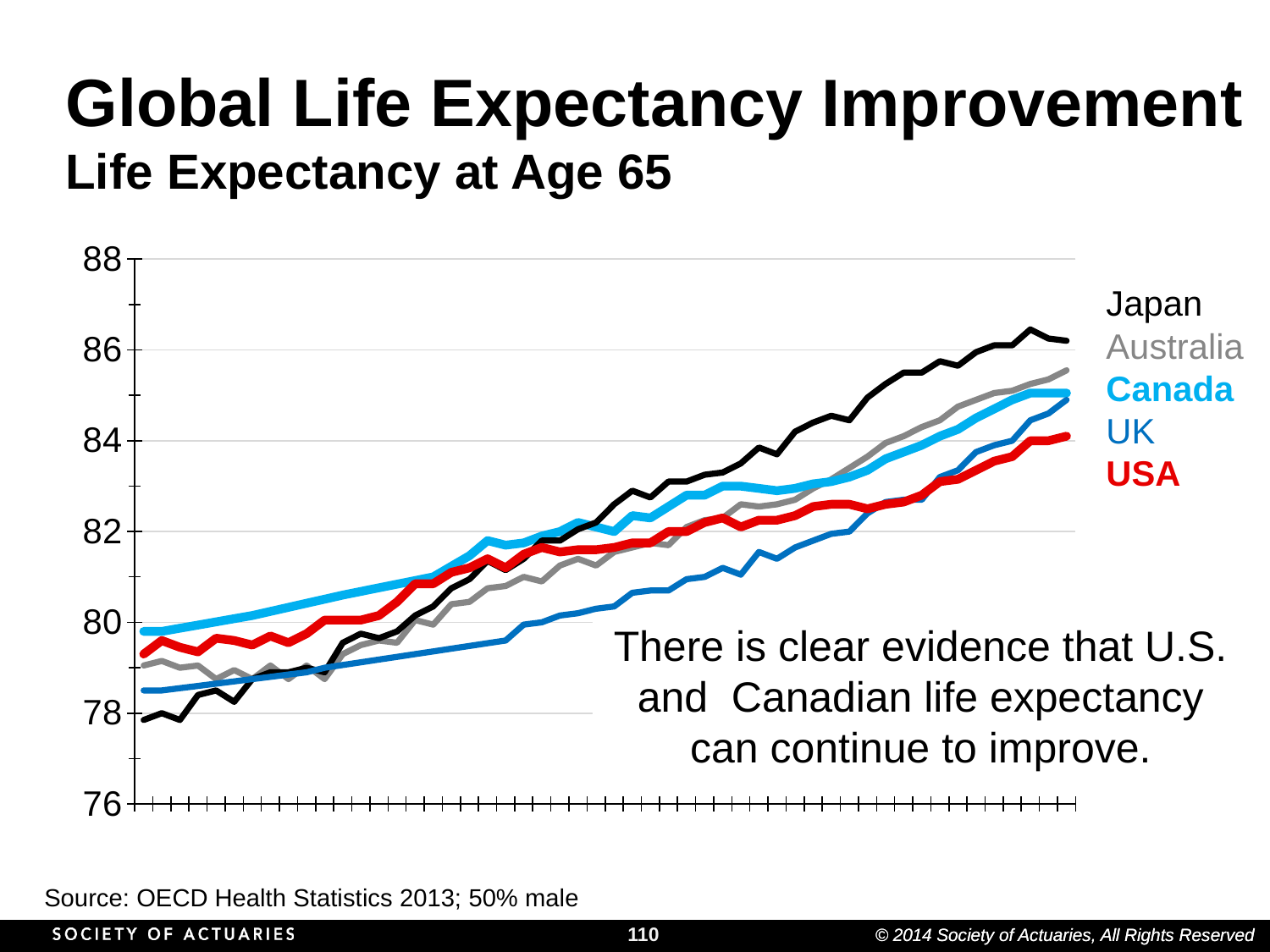
Is the value for the USA at the left end of the chart greater or less than 80? less Which country has the highest life expectancy at age 65 at the right end of the chart? Japan Which country has the highest life expectancy at age 65 at the left end of the chart? Canada What kind of chart is shown on the slide? line chart How many series does the legend list? 5 What colour is the line for the USA? red Is the value for Australia at the right end of the chart greater or less than 84? greater Which country has the lowest life expectancy at age 65 at the left end of the chart? Japan At the left end of the chart, which is higher: Canada or the UK? Canada Which country has the lowest life expectancy at age 65 at the right end of the chart? USA Is the peak value for Japan greater or less than 86? greater Do the life expectancy values generally rise or fall from left to right along the x axis? rise